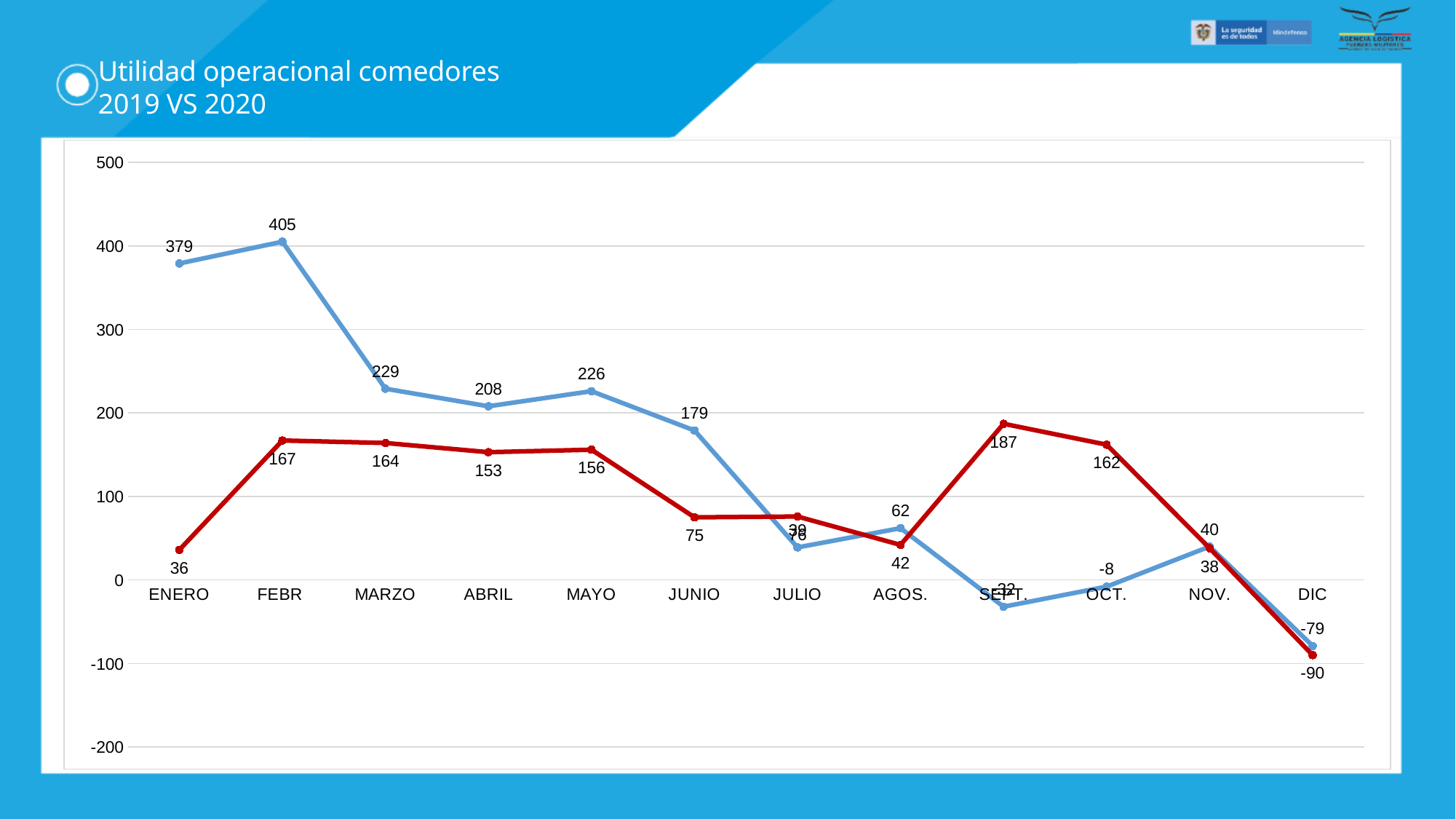
What is the value of the red line for SEPT.? 187 What is the title of the slide? Utilidad operacional comedores 2019 VS 2020 What kind of chart is shown on the slide? line chart What is the value of the blue line for FEBR? 405 In MAYO, which line has the larger value, the blue line or the red line? blue line What is the difference between the blue line and the red line in ENERO? 343 In which month does the red line reach its lowest value? DIC How many months are shown on the x axis? 12 In which month does the red line reach its highest value? SEPT. In which month does the blue line reach its highest value? FEBR What is the value of the red line for OCT.? 162 Does the red line rise or fall from SEPT. to DIC? fall